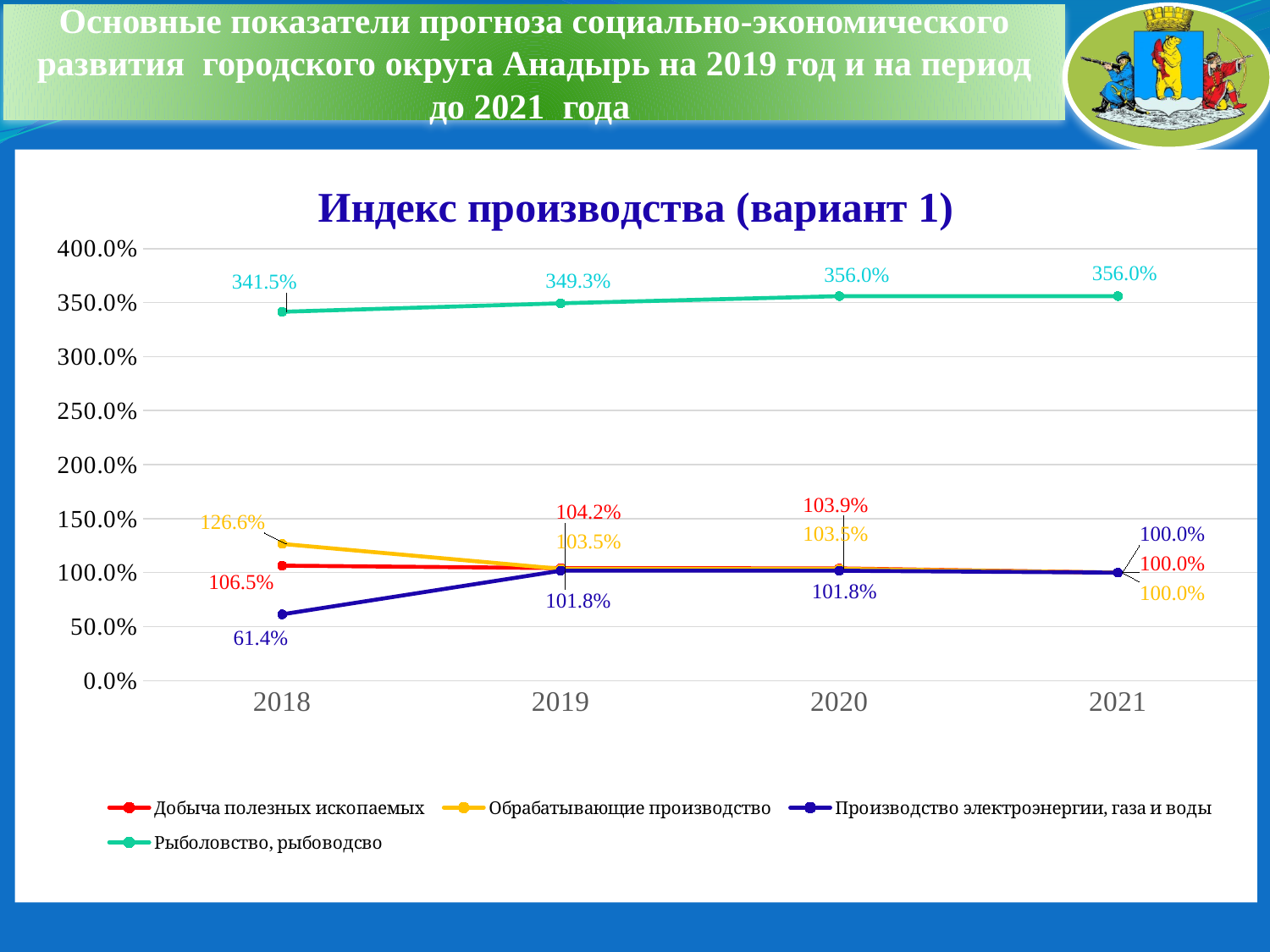
What is the value for Производство электроэнергии, газа и воды in 2018? 61.4% Which series has the lowest value in 2018? Производство электроэнергии, газа и воды What is the difference between the Рыболовство, рыбоводсво values in 2020 and 2018? 14.5% What is the value for Обрабатывающие производство in 2018? 126.6% What kind of chart is shown on the slide? line chart How many series does the legend list? 4 What is the value for Добыча полезных ископаемых in 2020? 103.9% What is the value for Рыболовство, рыбоводсво in 2018? 341.5% Does the Рыболовство, рыбоводсво line rise or fall from 2018 to 2020? rise What is the title of the chart? Индекс производства (вариант 1) Which series has the highest value in 2021? Рыболовство, рыбоводсво How many years are shown on the x axis? 4